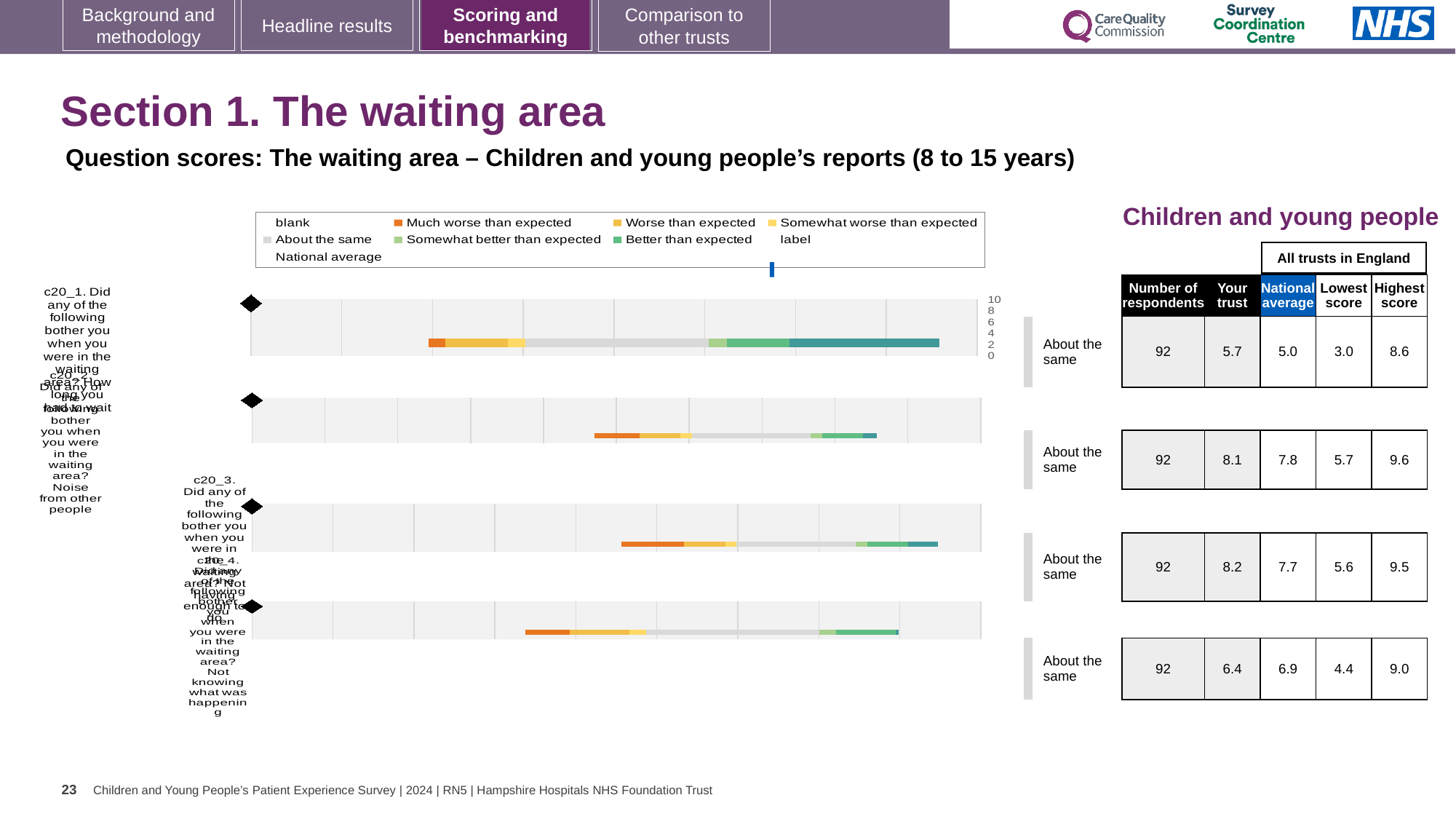
What kind of chart is used to show the question scores on this slide? bar chart In the fourth chart (c20_4), which is larger: the 'Your trust' score or the national average? national average In the first chart (c20_1), what is the difference between the 'Your trust' score and the national average? 0.7 What benchmark rating is shown next to each of the four charts? About the same How many respondents are shown for the first chart (c20_1)? 92 Which chart has the lowest 'Your trust' score? the first chart (c20_1) In the third chart (c20_3), what is the difference between the highest score and the lowest score? 3.9 Which chart has the highest 'Your trust' score? the third chart (c20_3) In the first chart (c20_1), what is the 'Your trust' score? 5.7 How many question charts (rows) are shown on the slide? 4 In the second chart (c20_2), what is the highest score among all trusts in England? 9.6 In the second chart (c20_2), what is the national average score? 7.8